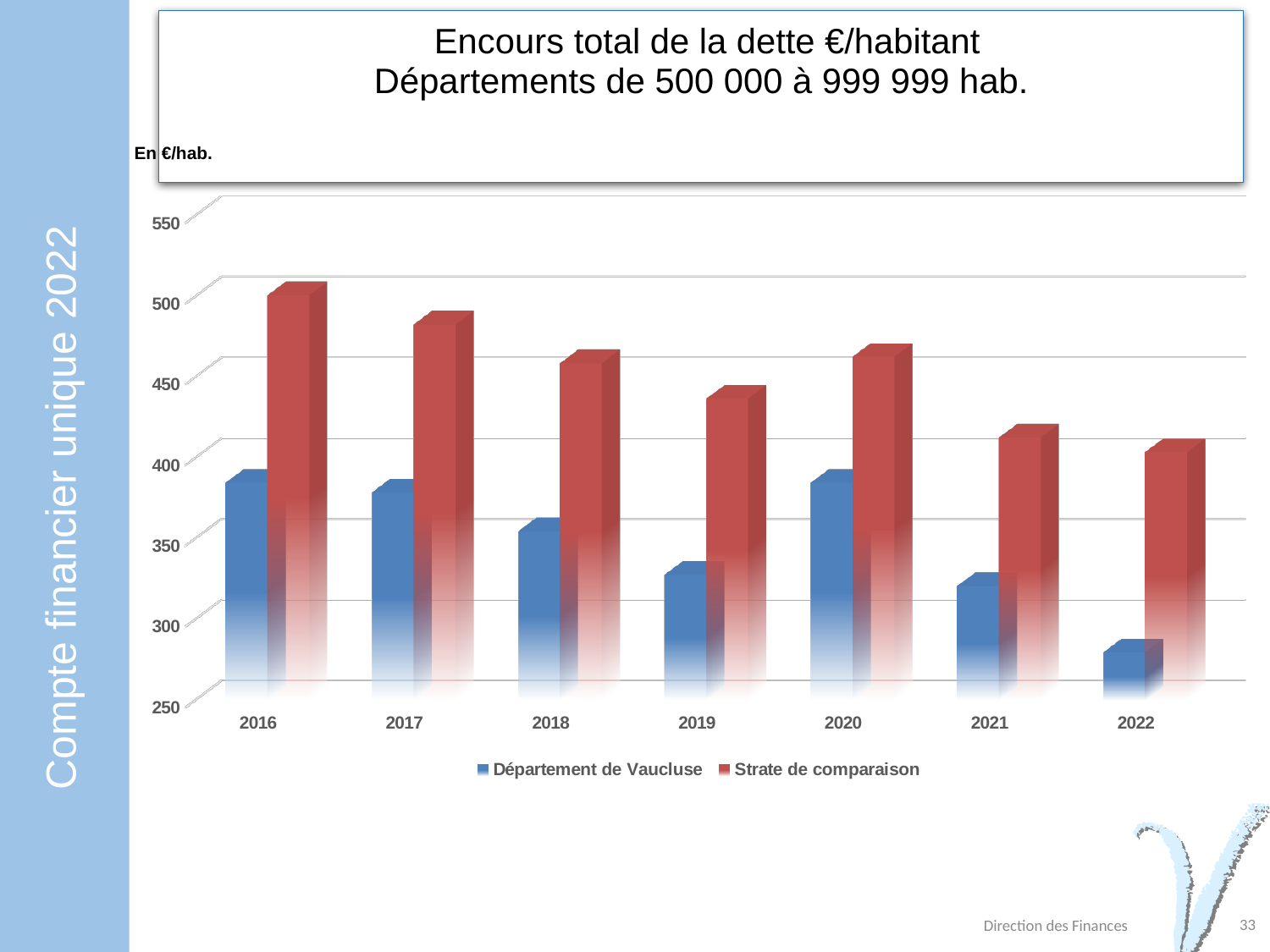
Is the value for Département de Vaucluse in 2022 greater or less than 300? less Is the value for Strate de comparaison in 2021 greater or less than 400? greater Is the value for Département de Vaucluse in 2019 greater or less than 350? less Which year has the highest value for Strate de comparaison? 2016 For Département de Vaucluse, which year has the larger value, 2018 or 2022? 2018 How many years are shown on the x axis? 7 What unit is indicated above the chart's vertical axis? En €/hab. Which year has the lowest value for Département de Vaucluse? 2022 How many series does the legend list? 2 What kind of chart is shown on the slide? bar chart In 2016, which series has the larger value, Département de Vaucluse or Strate de comparaison? Strate de comparaison